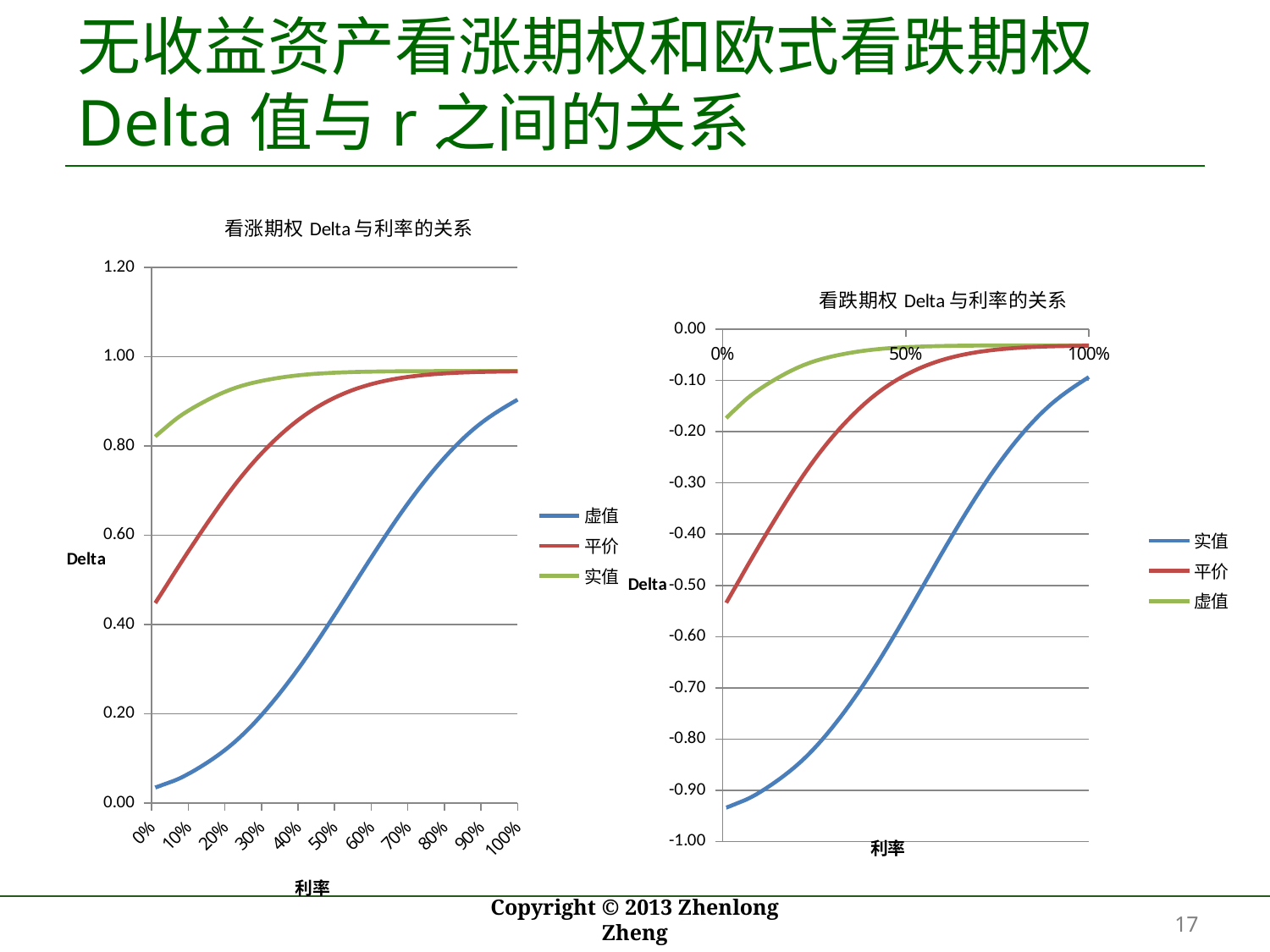
In the left chart (看涨期权 Delta 与利率的关系), is the value of 虚值 at 100% greater or less than 0.80? greater In the left chart (看涨期权 Delta 与利率的关系), which series has the larger value at 0%: 实值 or 虚值? 实值 How many series does the legend of the right chart (看跌期权 Delta 与利率的关系) list? 3 What is the x-axis title of the right chart (看跌期权 Delta 与利率的关系)? 利率 In the left chart (看涨期权 Delta 与利率的关系), does the 虚值 line rise or fall as 利率 increases? rise In the right chart (看跌期权 Delta 与利率的关系), does the 平价 line rise or fall as 利率 increases? rise In the left chart (看涨期权 Delta 与利率的关系), what are the three series named in the legend? 虚值, 平价, 实值 What kind of chart is the left chart titled 看涨期权 Delta 与利率的关系? line chart In the right chart (看跌期权 Delta 与利率的关系), is the value of 虚值 at 0% greater or less than -0.30? greater In the right chart (看跌期权 Delta 与利率的关系), is the value of 实值 at 0% greater or less than -0.80? less